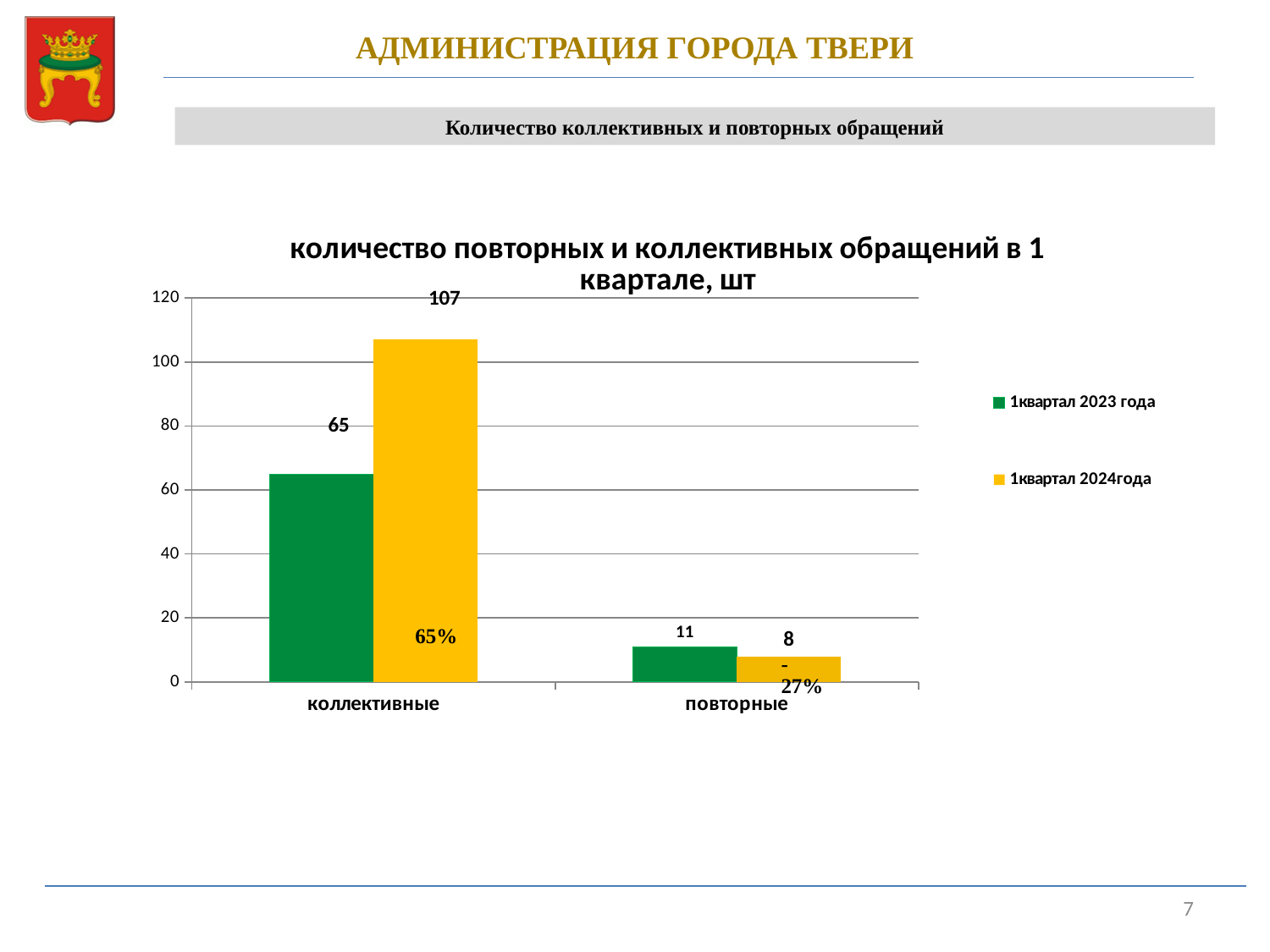
What is the difference between the 1квартал 2023 года and 1квартал 2024года values for повторные? 3 Which category has the highest value in 1квартал 2024года? коллективные How many categories are shown on the x axis? 2 Which is larger for повторные: 1квартал 2023 года or 1квартал 2024года? 1квартал 2023 года What is the value for коллективные in 1квартал 2024года? 107 What is the value for повторные in 1квартал 2023 года? 11 Which category has the lowest value in 1квартал 2023 года? повторные What kind of chart is shown on the slide? bar chart How many series does the legend list? 2 What is the difference between the 1квартал 2024года and 1квартал 2023 года values for коллективные? 42 What is the value for повторные in 1квартал 2024года? 8 What is the value for коллективные in 1квартал 2023 года? 65